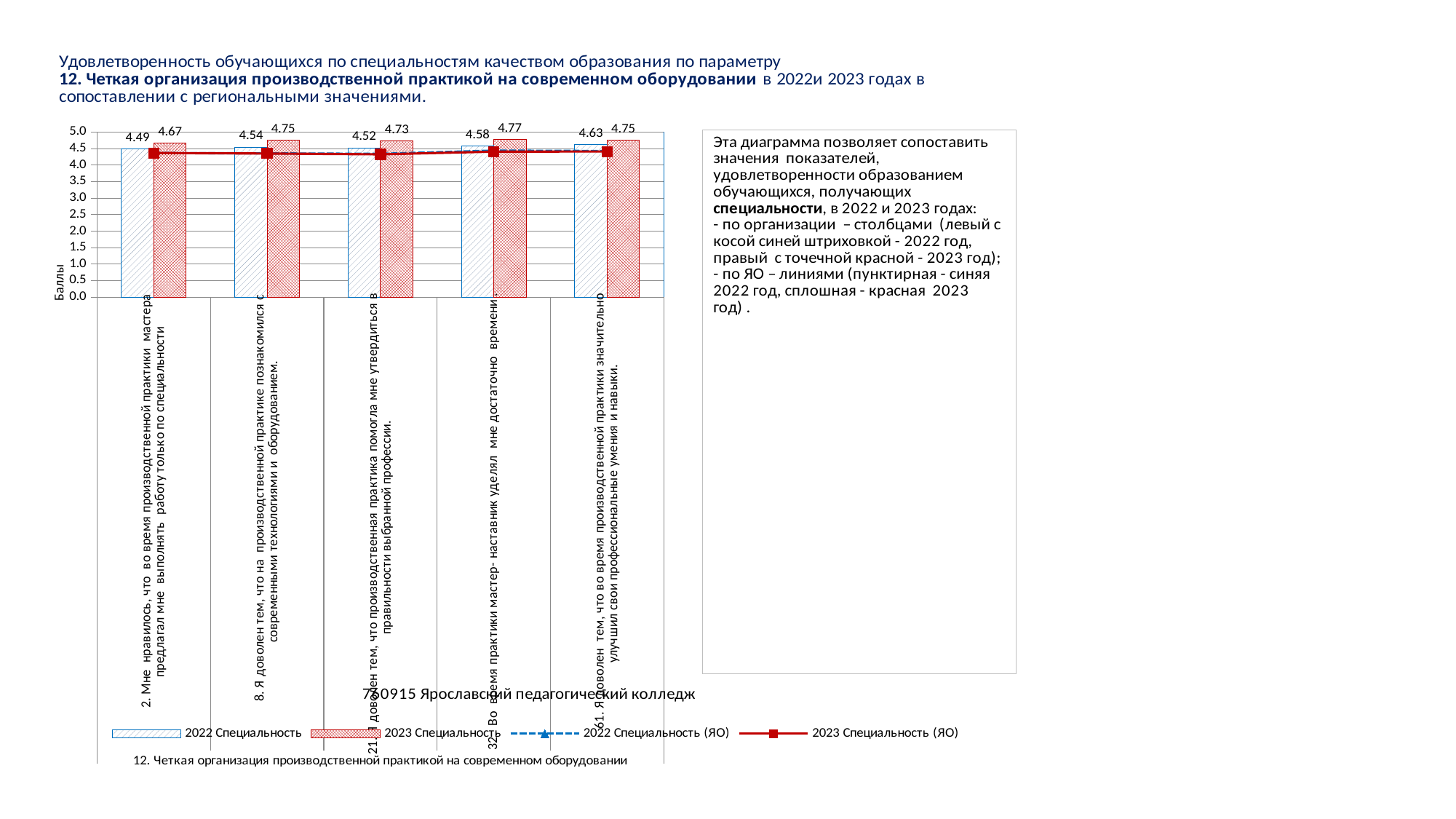
Which item has the lowest 2022 Специальность bar? 2. Мне нравилось, что во время производственной практики мастер предлагал мне выполнять работу только по специальности (4.49) Which item has the highest 2023 Специальность bar? 32. Во время практики мастер-наставник уделял мне достаточно времени (4.77) What is the value of the 2023 Специальность bar for item 61 ("значительно улучшил свои профессиональные умения и навыки")? 4.75 For item 61, which is larger: the 2022 Специальность bar or the 2023 Специальность bar? 2023 Специальность (4.75) What is the value of the 2022 Специальность bar for item 21 ("производственная практика помогла мне утвердиться в правильности выбранной профессии")? 4.52 How many survey items (categories) are shown on the x axis? 5 Is the 2023 Специальность (ЯО) line value for item 2 greater or less than 4.0? greater What is the difference between the 2023 and 2022 Специальность values for item 32 ("мастер-наставник уделял мне достаточно времени")? 0.19 What kind of chart is shown on the slide? A combined bar and line chart What is the value of the 2023 Специальность bar for item 8 ("Я доволен тем, что на производственной практике познакомился с современными технологиями и оборудованием")? 4.75 What is the value of the 2022 Специальность bar for item 2 ("Мне нравилось, что во время производственной практики мастер предлагал мне выполнять работу только по специальности")? 4.49 How many series does the legend list? 4